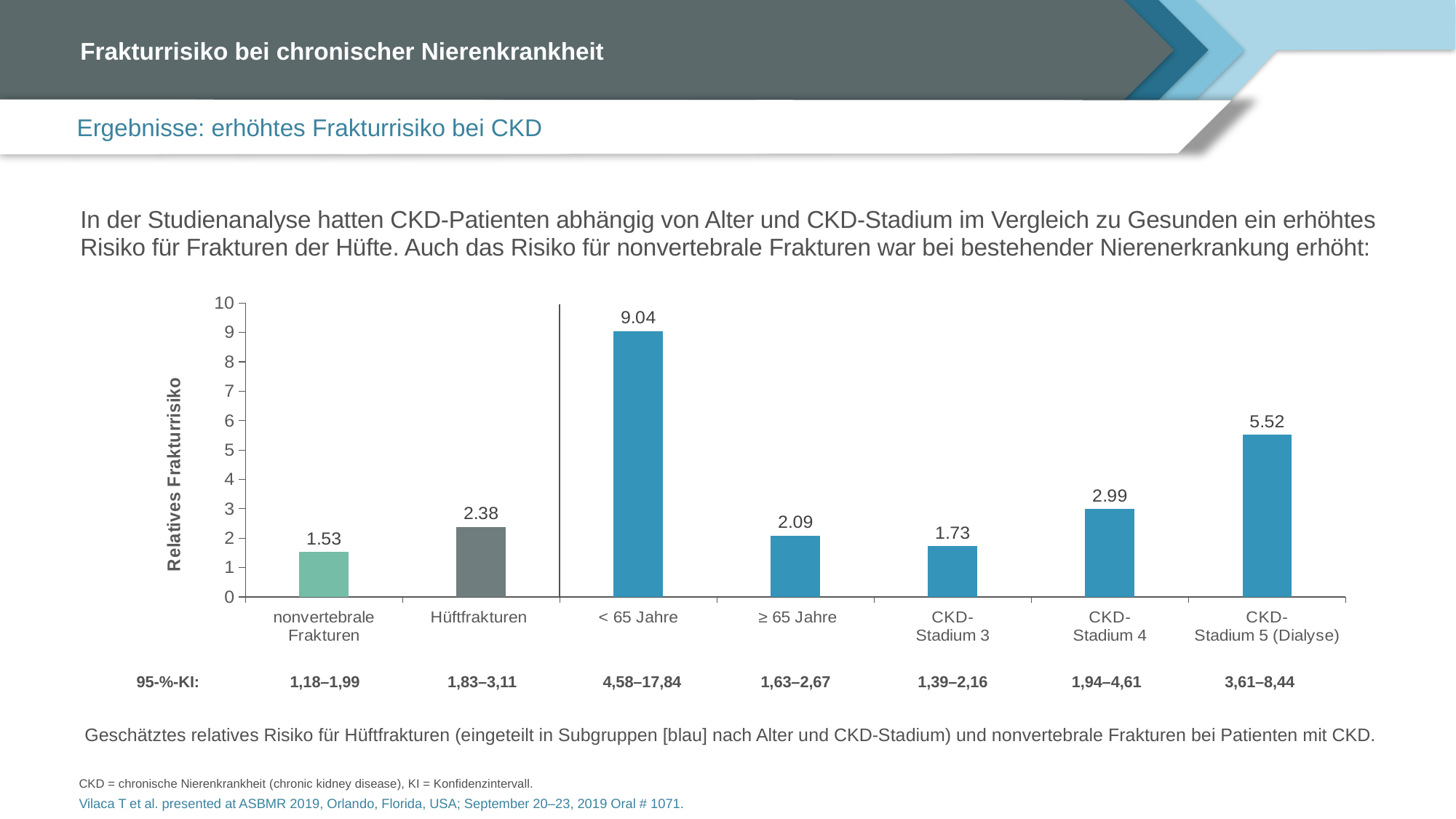
What is the label of the y axis of the chart? Relatives Frakturrisiko What is the relative fracture risk value shown for 'CKD-Stadium 5 (Dialyse)'? 5.52 What is the 95-%-KI shown below the chart for '< 65 Jahre'? 4,58–17,84 Which category has the highest relative fracture risk? < 65 Jahre What is the value shown for 'nonvertebrale Frakturen'? 1.53 Which is larger, the value for 'Hüftfrakturen' or the value for '≥ 65 Jahre'? Hüftfrakturen How many categories are shown on the x axis of the chart? 7 What is the relative fracture risk value shown for '< 65 Jahre'? 9.04 What kind of chart is shown on the slide? bar chart Is the value for 'CKD-Stadium 5 (Dialyse)' greater or less than 5? greater Which category has the lowest relative fracture risk? nonvertebrale Frakturen What is the difference between the values for 'CKD-Stadium 4' and 'CKD-Stadium 3'? 1.26